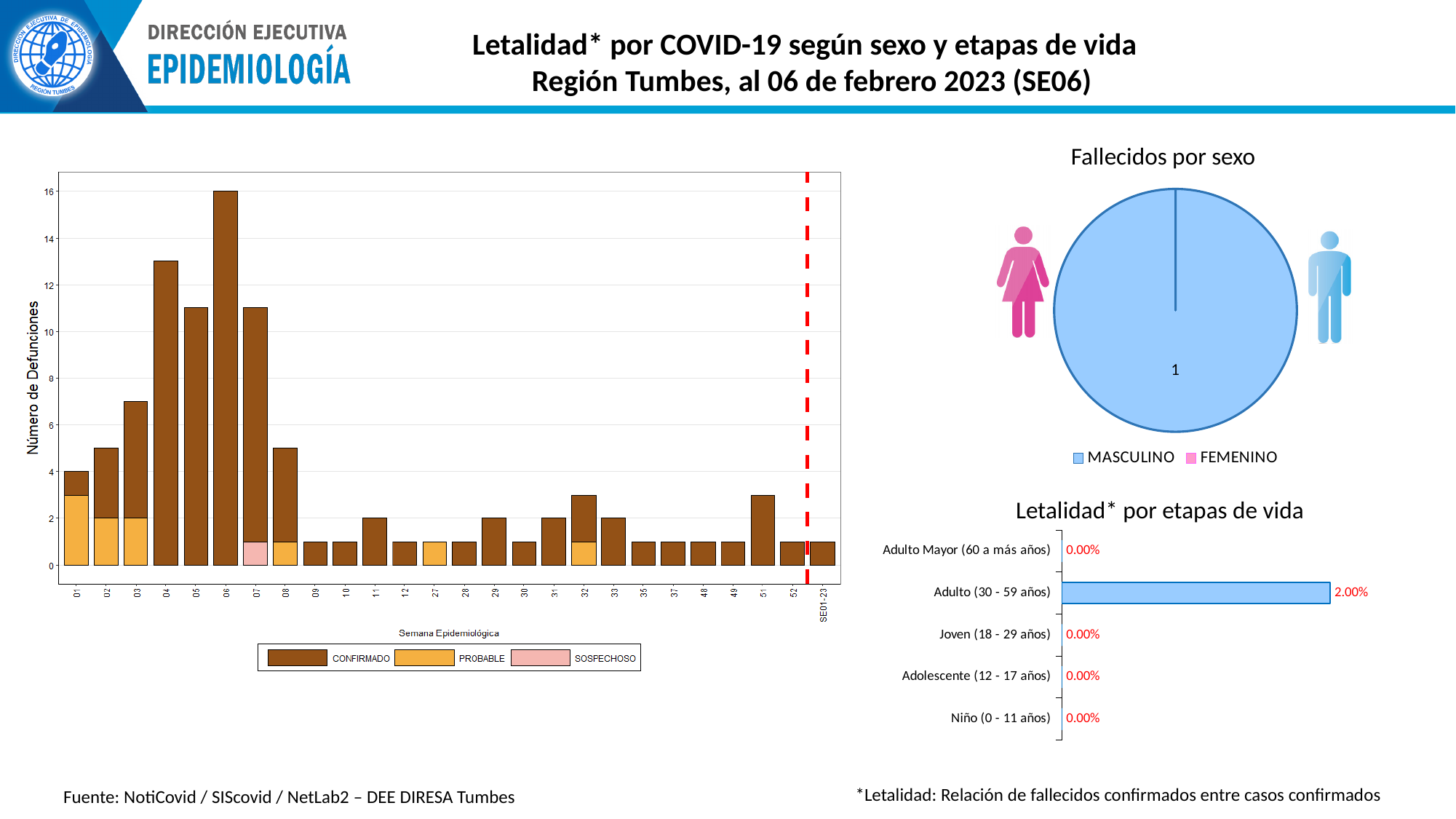
In the 'Número de Defunciones' bar chart on the left, how many series does the legend list? 3 In the 'Letalidad* por etapas de vida' chart, what is the value for Niño (0 - 11 años)? 0.00% In the 'Número de Defunciones' bar chart on the left, what is the total number of deaths in week 06? 16 How many age groups are shown in the 'Letalidad* por etapas de vida' chart? 5 In the 'Número de Defunciones' bar chart on the left, is the value for week 04 greater or less than 12? greater What kind of chart is 'Fallecidos por sexo'? pie chart In the 'Letalidad* por etapas de vida' chart, what is the value for Adulto (30 - 59 años)? 2.00% What kind of chart is 'Letalidad* por etapas de vida'? bar chart In the 'Fallecidos por sexo' chart, what value is shown for MASCULINO? 1 In the 'Número de Defunciones' bar chart on the left, which epidemiological week has the highest number of deaths? 06 In the 'Letalidad* por etapas de vida' chart, which age group has the highest value? Adulto (30 - 59 años) How many entries does the legend of the 'Fallecidos por sexo' chart list? 2